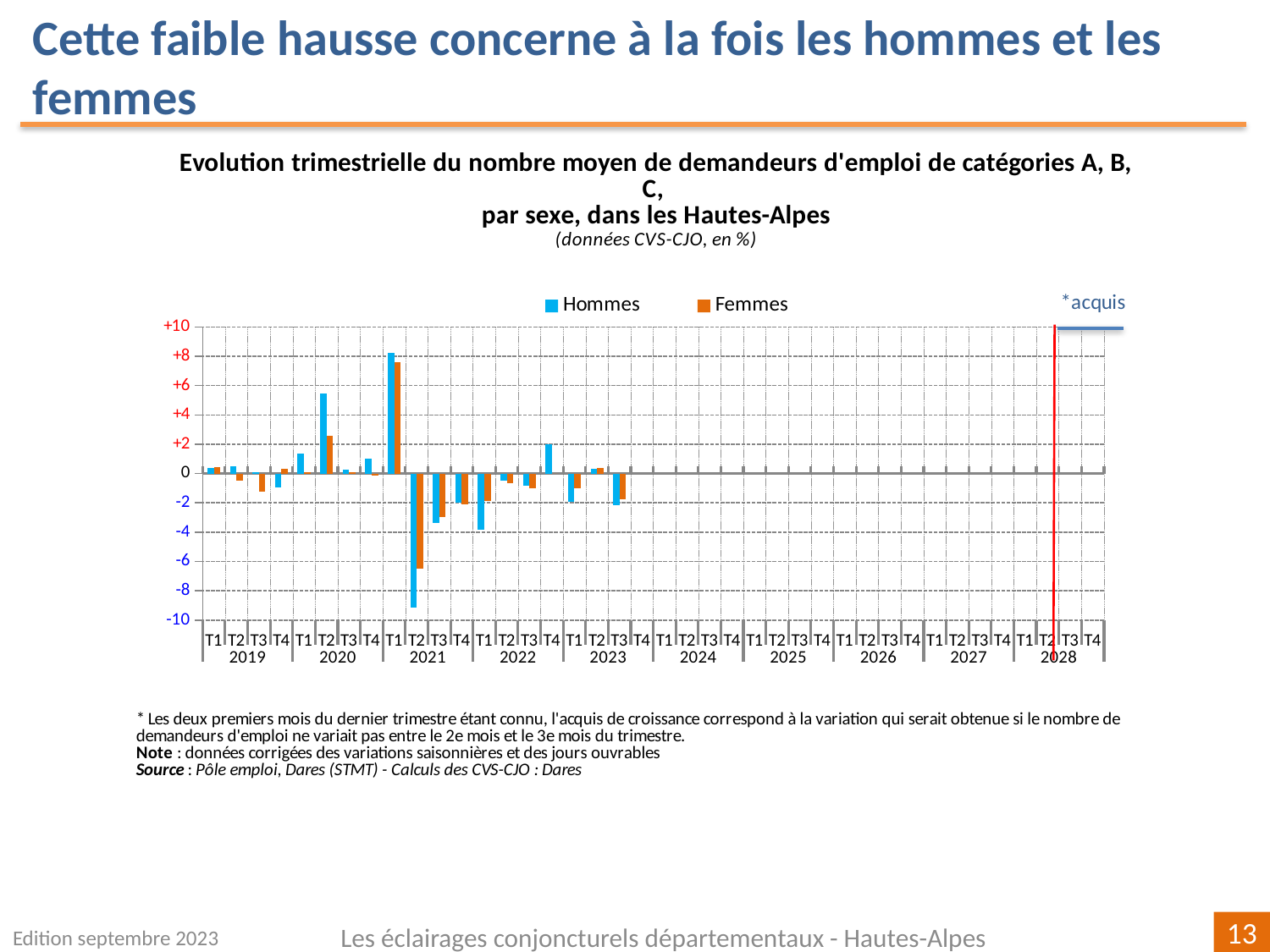
In which quarter does the Hommes series reach its highest value? T1 2021 What kind of chart is shown on the slide? bar chart Is the value for Hommes in T2 2020 greater or less than +4? greater In which quarter does the Hommes series reach its lowest value? T2 2021 How many series does the legend list? 2 Which two series are listed in the legend? Hommes and Femmes Is the value for Hommes in T2 2021 greater or less than -8? less Is the value for Femmes in T2 2021 greater or less than -4? less Which colour represents the Femmes series? orange In which quarter does the Femmes series reach its lowest value? T2 2021 In T2 2020, which series has the larger value, Hommes or Femmes? Hommes